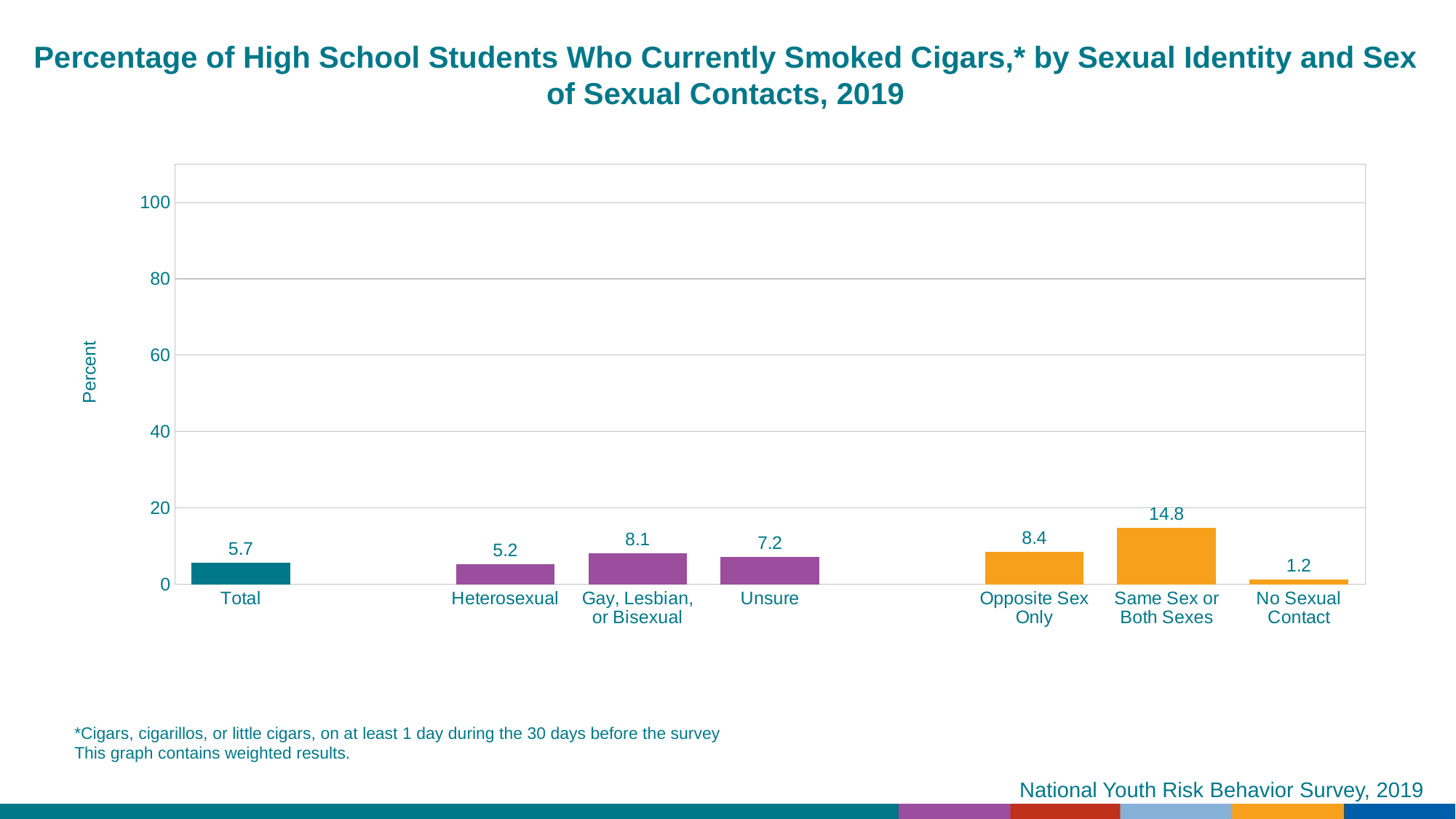
Which is larger, the value for Unsure or the value for Heterosexual? Unsure What is the value for Total? 5.7 Which category has the highest value? Same Sex or Both Sexes What is the difference between the values for Same Sex or Both Sexes and Opposite Sex Only? 6.4 What kind of chart is shown on the slide? Bar chart Is the value for Same Sex or Both Sexes greater or less than 20? less What is the difference between the values for Gay, Lesbian, or Bisexual and Heterosexual? 2.9 How many bars are shown in the chart? 7 What percentage of students who are Gay, Lesbian, or Bisexual currently smoked cigars? 8.1 Which category has the lowest value? No Sexual Contact What is the value for Same Sex or Both Sexes? 14.8 What is the value for No Sexual Contact? 1.2